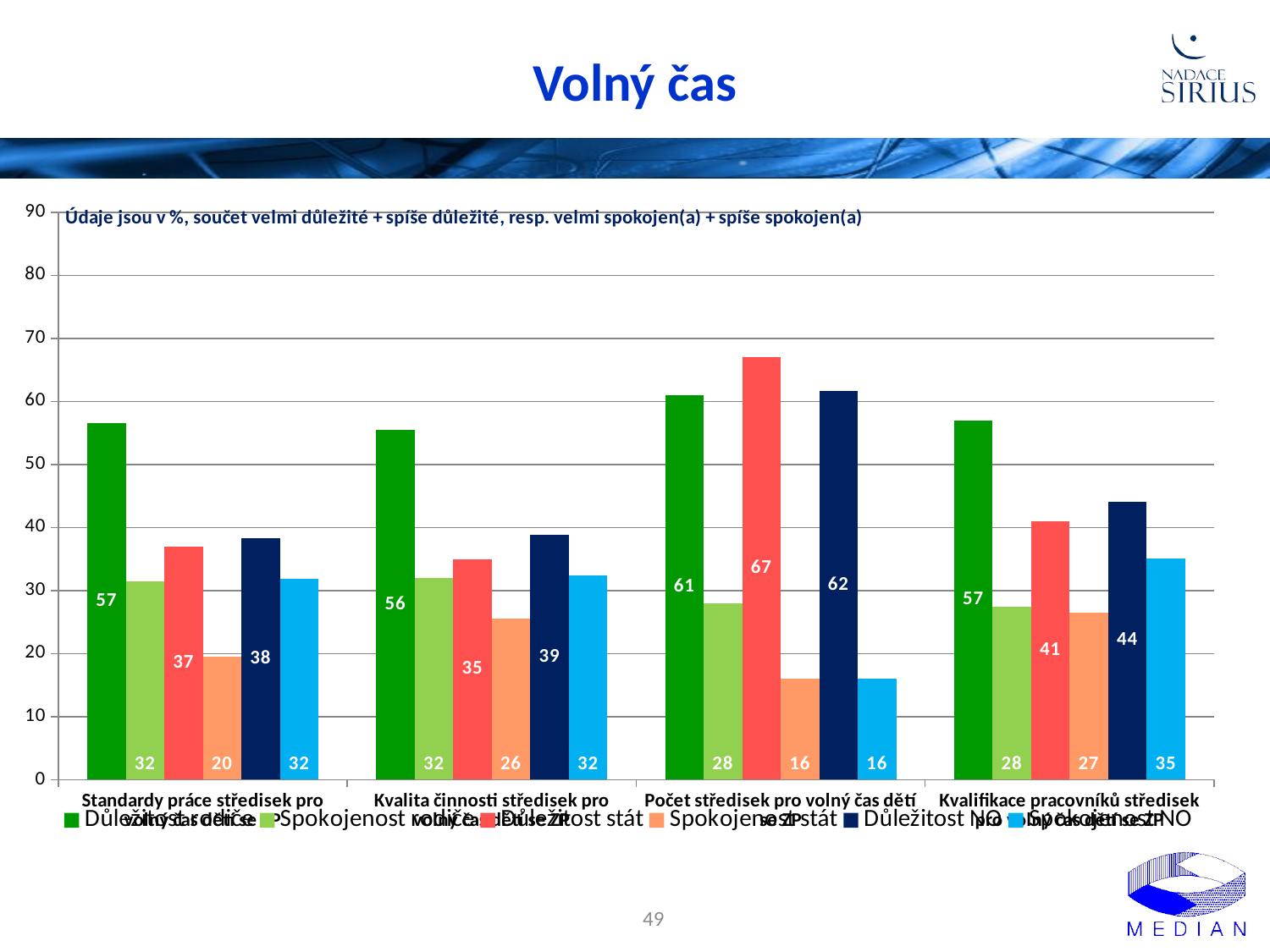
What kind of chart is shown on the slide? bar chart How many category groups are shown on the x axis of the chart? 4 How many series does the chart legend list? 6 What is the difference between Důležitost stát and Spokojenost stát for Počet středisek pro volný čas dětí? 51 What is the value of Spokojenost stát for the category Standardy práce středisek? 20 What is the highest value shown in the chart? 67 What is the title of the slide containing the chart? Volný čas What is the value of Důležitost stát for the category Počet středisek pro volný čas dětí? 67 What is the lowest value in the Počet středisek pro volný čas dětí group? 16